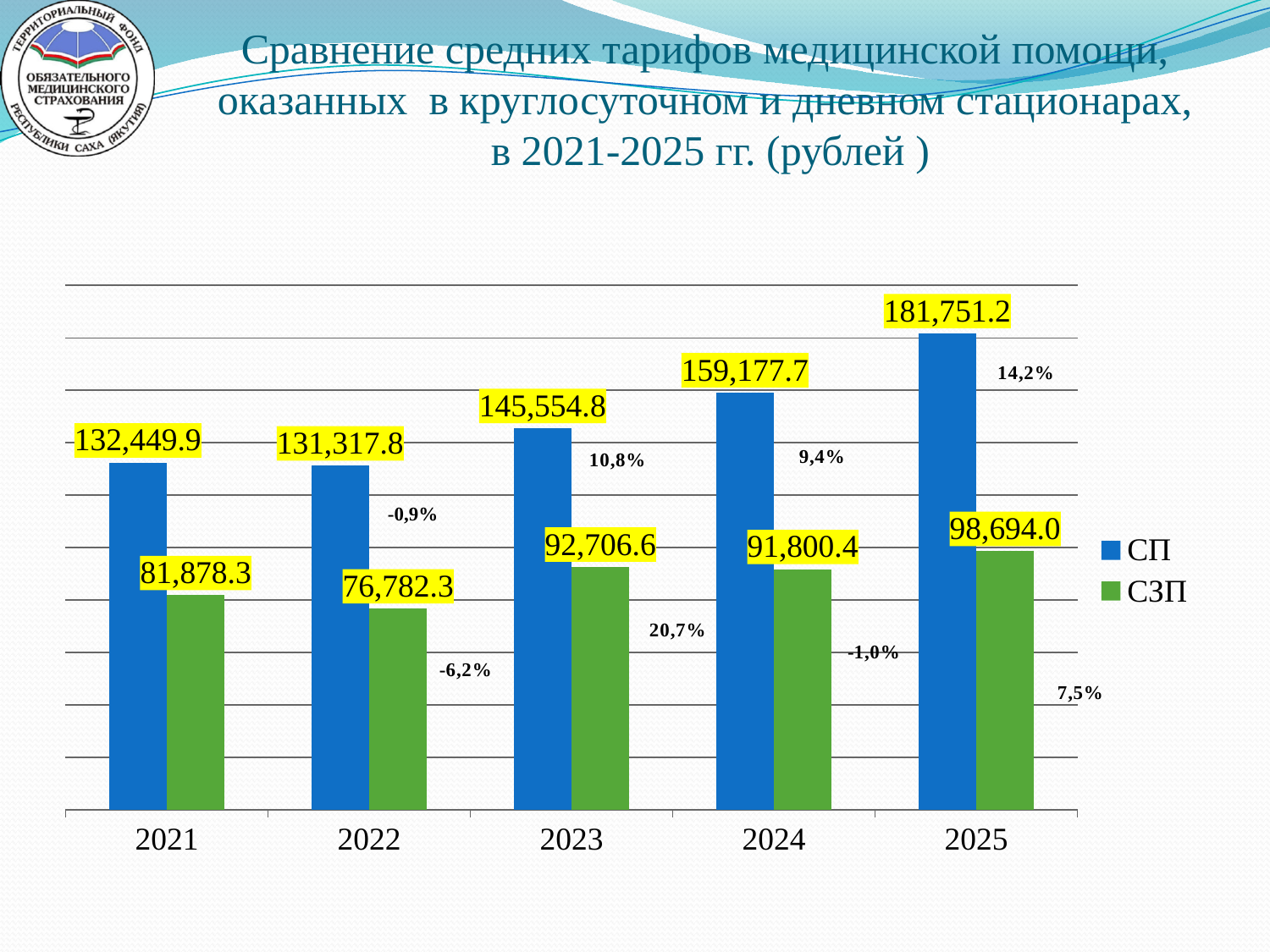
In which year is the СЗП value lowest? 2022 What is the value of СЗП for 2022? 76,782.3 What is the value of СЗП for 2024? 91,800.4 What kind of chart is shown on the slide? bar chart What is the value of СП for 2023? 145,554.8 What is the value of СП for 2025? 181,751.2 In which year is the СП value highest? 2025 Which is larger: the СЗП value for 2023 or for 2024? 2023 What is the difference between the СП and СЗП values for 2021? 50,571.6 How many series does the legend list? 2 How many years are shown on the x axis? 5 What is the difference between the СП values for 2025 and 2024? 22,573.5